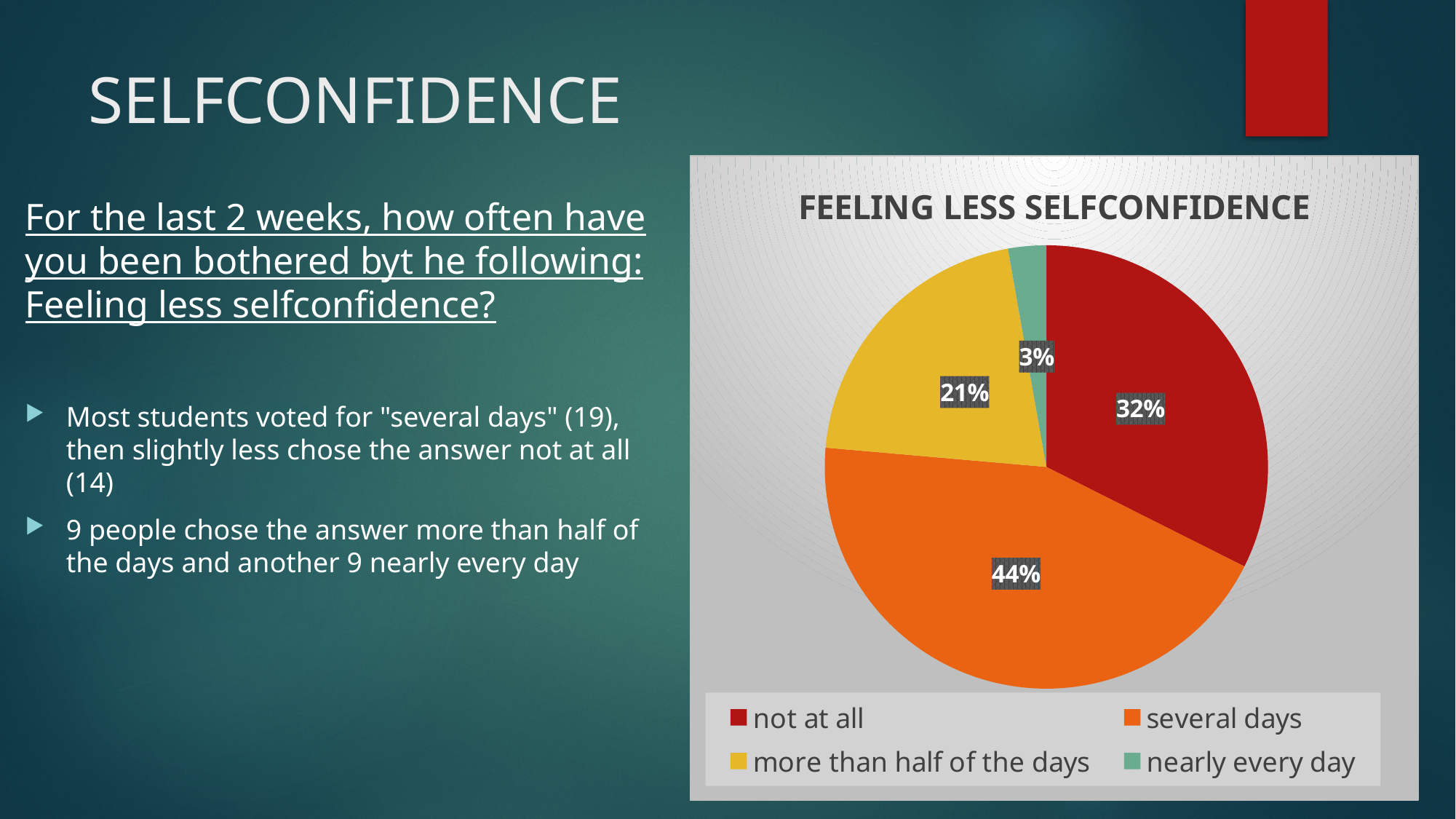
What is the title of the chart? FEELING LESS SELFCONFIDENCE What percentage of the pie is labelled for "several days"? 44% What colour is the slice for "more than half of the days"? yellow What type of chart is shown on the slide? pie chart Which is larger, the slice for "not at all" or the slice for "more than half of the days"? not at all What percentage of the pie is labelled for "more than half of the days"? 21% Which category has the largest slice of the pie? several days What is the difference in percentage points between "several days" and "not at all"? 12 What percentage of the pie is labelled for "nearly every day"? 3% How many categories does the pie chart show? 4 What percentage of the pie is labelled for "not at all"? 32% Which category has the smallest slice of the pie? nearly every day